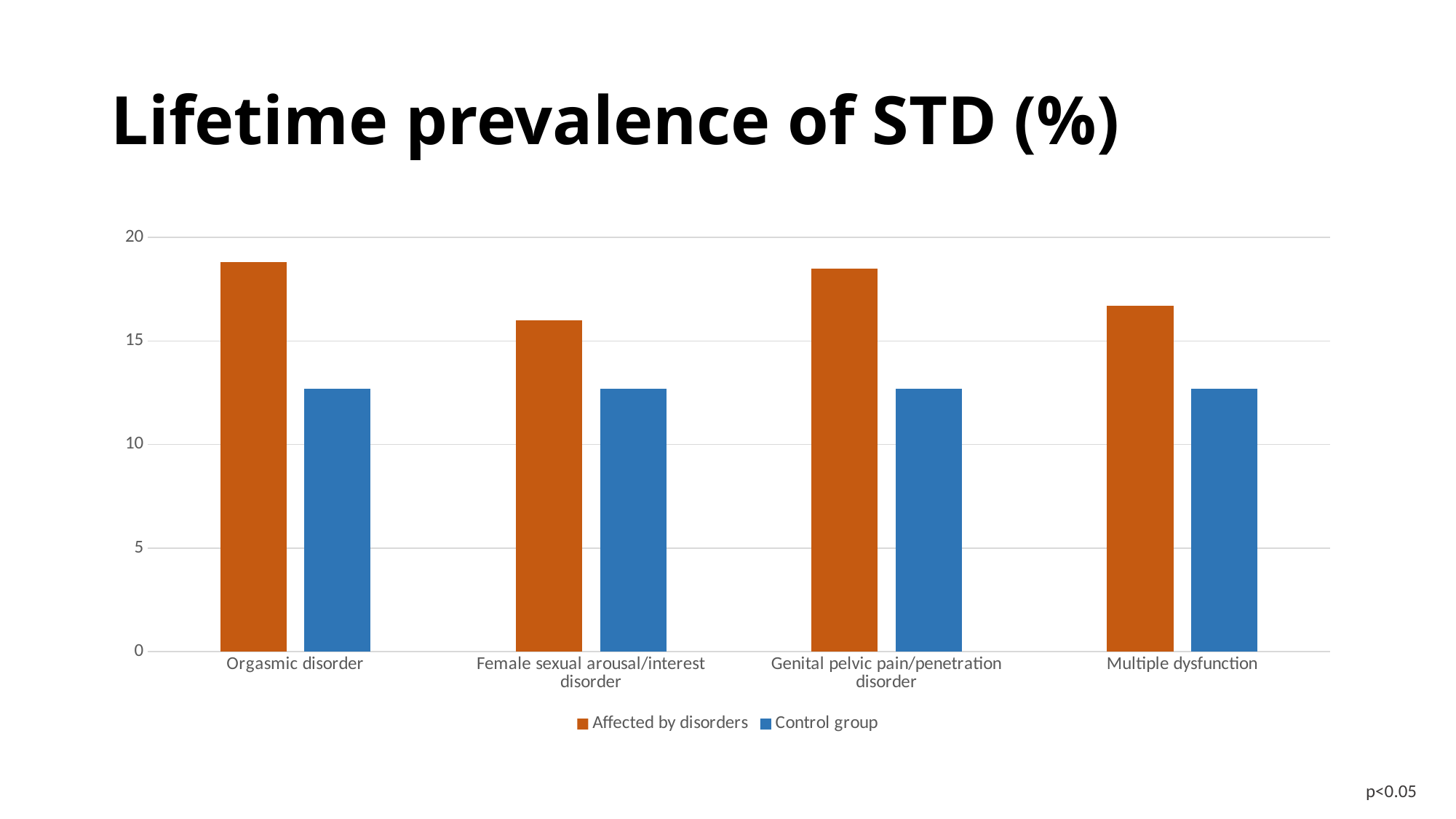
Which series is shown in orange? Affected by disorders Which is larger for Affected by disorders: Genital pelvic pain/penetration disorder or Multiple dysfunction? Genital pelvic pain/penetration disorder What is the title of the chart? Lifetime prevalence of STD (%) Which is larger for Affected by disorders: Orgasmic disorder or Female sexual arousal/interest disorder? Orgasmic disorder How many series does the legend list? 2 Is the value for Control group in Orgasmic disorder greater or less than 15? less Is the value for Affected by disorders in Genital pelvic pain/penetration disorder greater or less than 15? greater What kind of chart is shown on the slide? bar chart How many categories are shown on the x axis? 4 In Multiple dysfunction, which series has the larger value: Affected by disorders or Control group? Affected by disorders Is the value for Control group in Multiple dysfunction greater or less than 10? greater